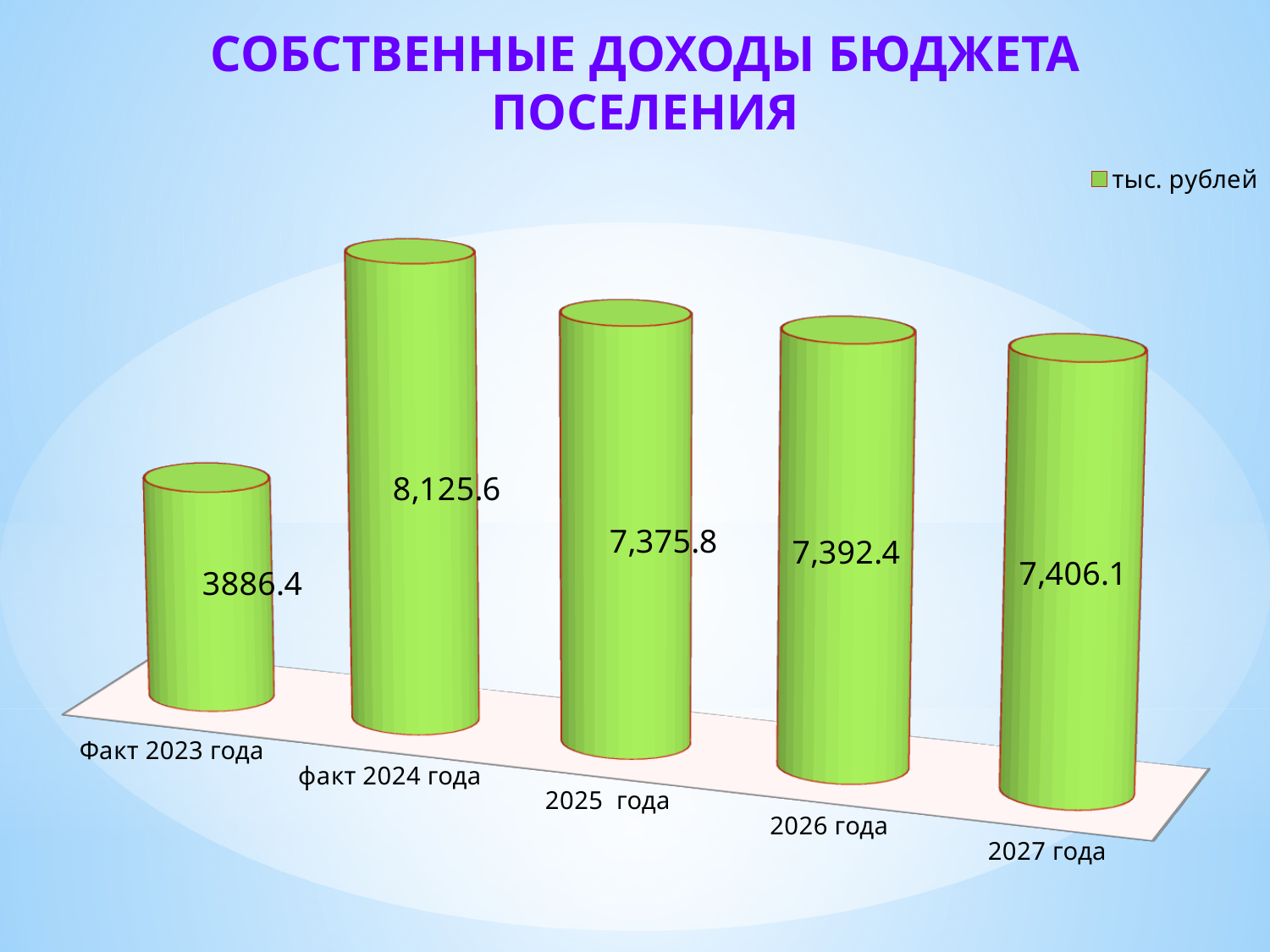
What is the value for Факт 2023 года? 3886.4 What is the value for 2027 года? 7,406.1 Which category has the lowest value? Факт 2023 года What unit does the legend give for the series? тыс. рублей What is the difference between the values for факт 2024 года and 2025 года? 749.8 What is the value for факт 2024 года? 8,125.6 What is the value for 2025 года? 7,375.8 What kind of chart is shown on the slide? bar chart Which category has the highest value? факт 2024 года What is the difference between the values for факт 2024 года and Факт 2023 года? 4,239.2 Which is larger, the value for факт 2024 года or the value for 2026 года? факт 2024 года How many categories are shown in the chart? 5